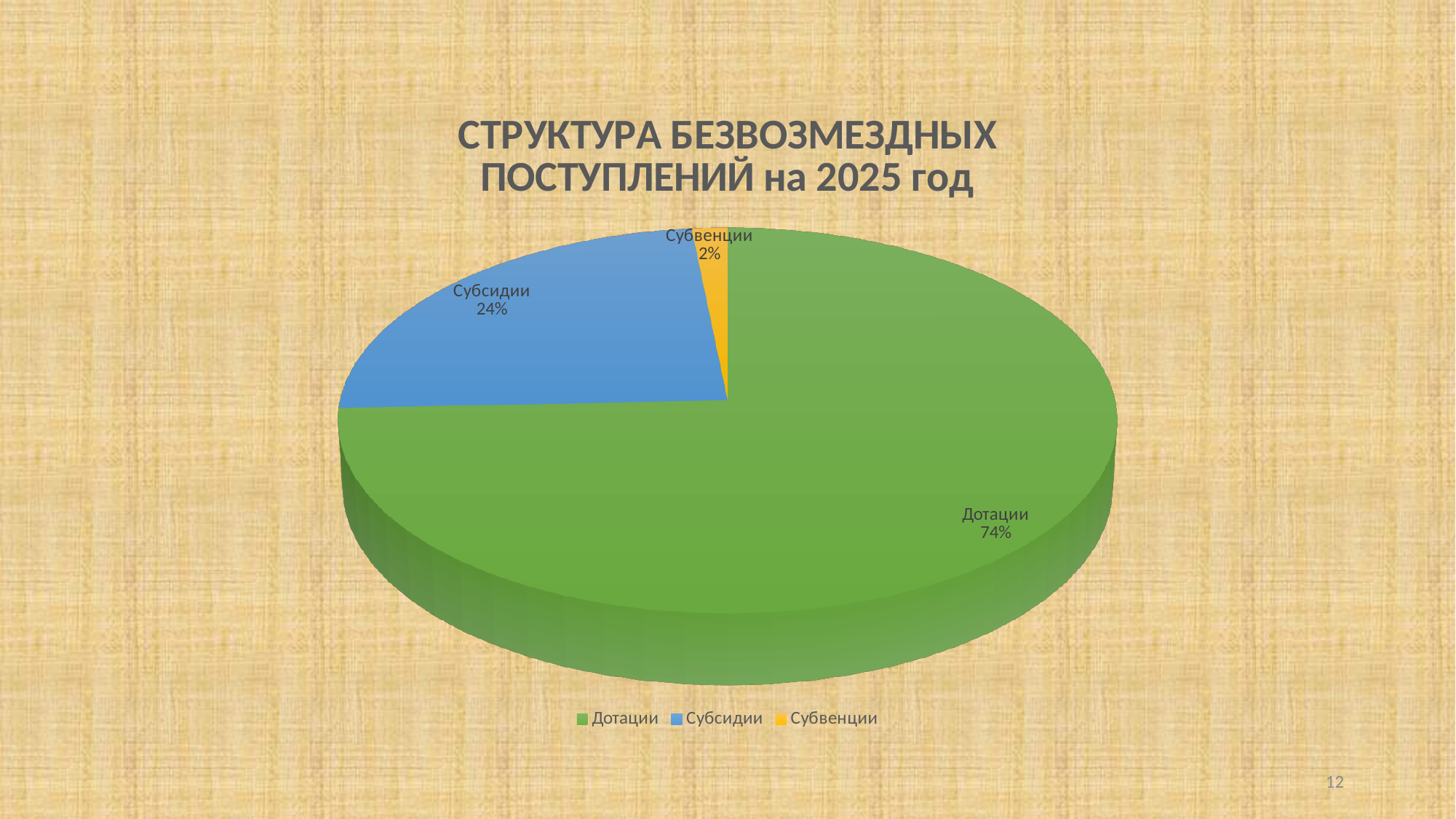
What is the title of the chart? СТРУКТУРА БЕЗВОЗМЕЗДНЫХ ПОСТУПЛЕНИЙ на 2025 год What share of the pie does Субвенции have? 2% Which is larger, the share for Субсидии or the share for Субвенции? Субсидии What colour is the Субсидии slice? Blue Which category has the smallest slice of the pie? Субвенции What is the difference in percentage points between Дотации and Субсидии? 50 How many categories are shown in the pie chart? 3 What is the difference in percentage points between Субсидии and Субвенции? 22 Which category has the largest slice of the pie? Дотации What share of the pie does Субсидии have? 24% What share of the pie does Дотации have? 74% What kind of chart is shown on the slide? Pie chart